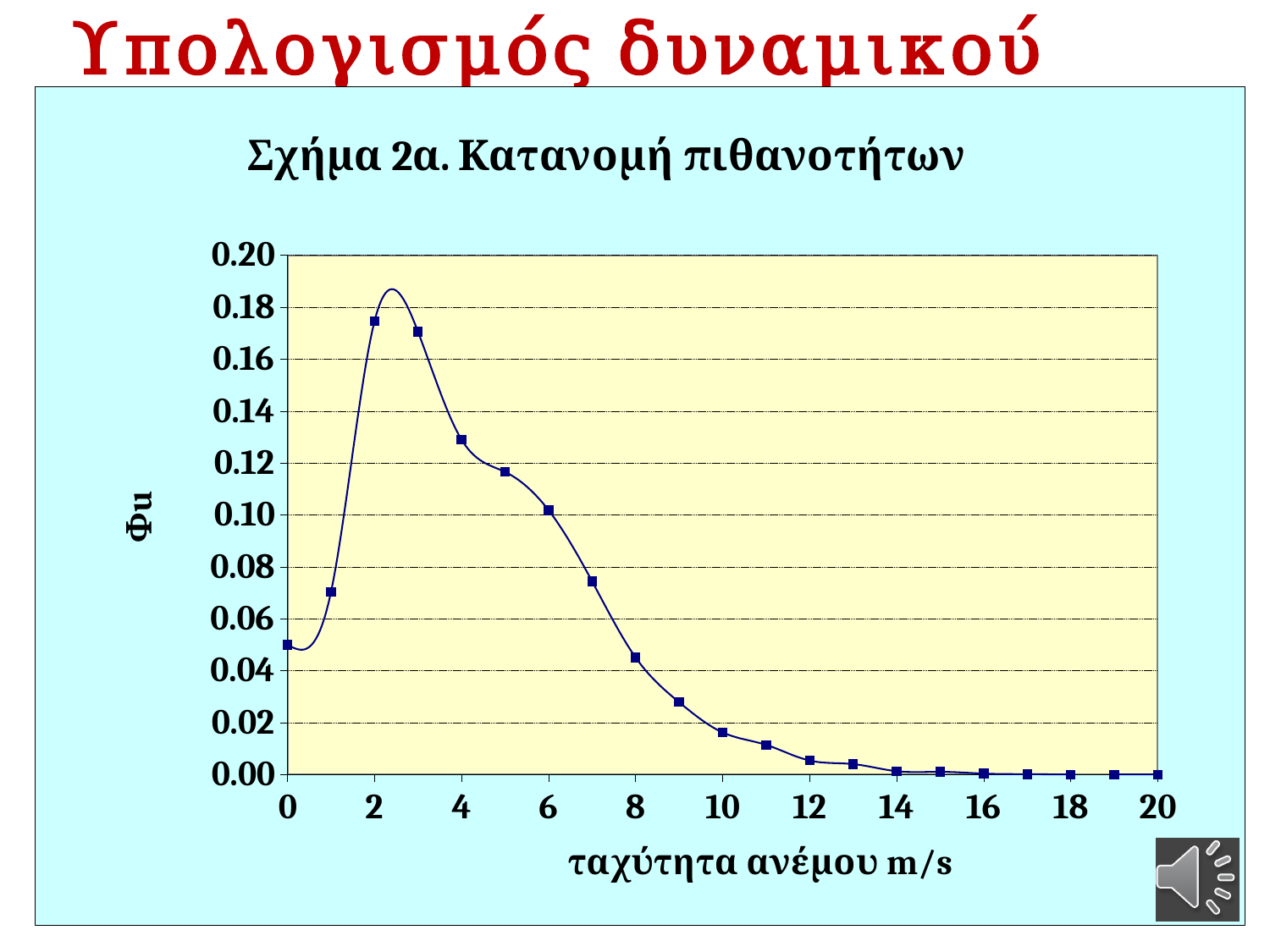
At which wind speed does the plotted value reach its highest point? 2 What is the title of the chart? Σχήμα 2α. Κατανομή πιθανοτήτων Is the value at wind speed 2 greater or less than 0.16? greater How many data points are plotted on the line? 21 Do the values rise or fall along the x axis from wind speed 2 to wind speed 20? fall Is the value at wind speed 10 greater or less than 0.02? less What kind of chart is shown on the slide? line chart What is the label of the x axis? ταχύτητα ανέμου m/s Which has the larger value, wind speed 4 or wind speed 8? 4 Is the value at wind speed 0 greater or less than 0.06? less